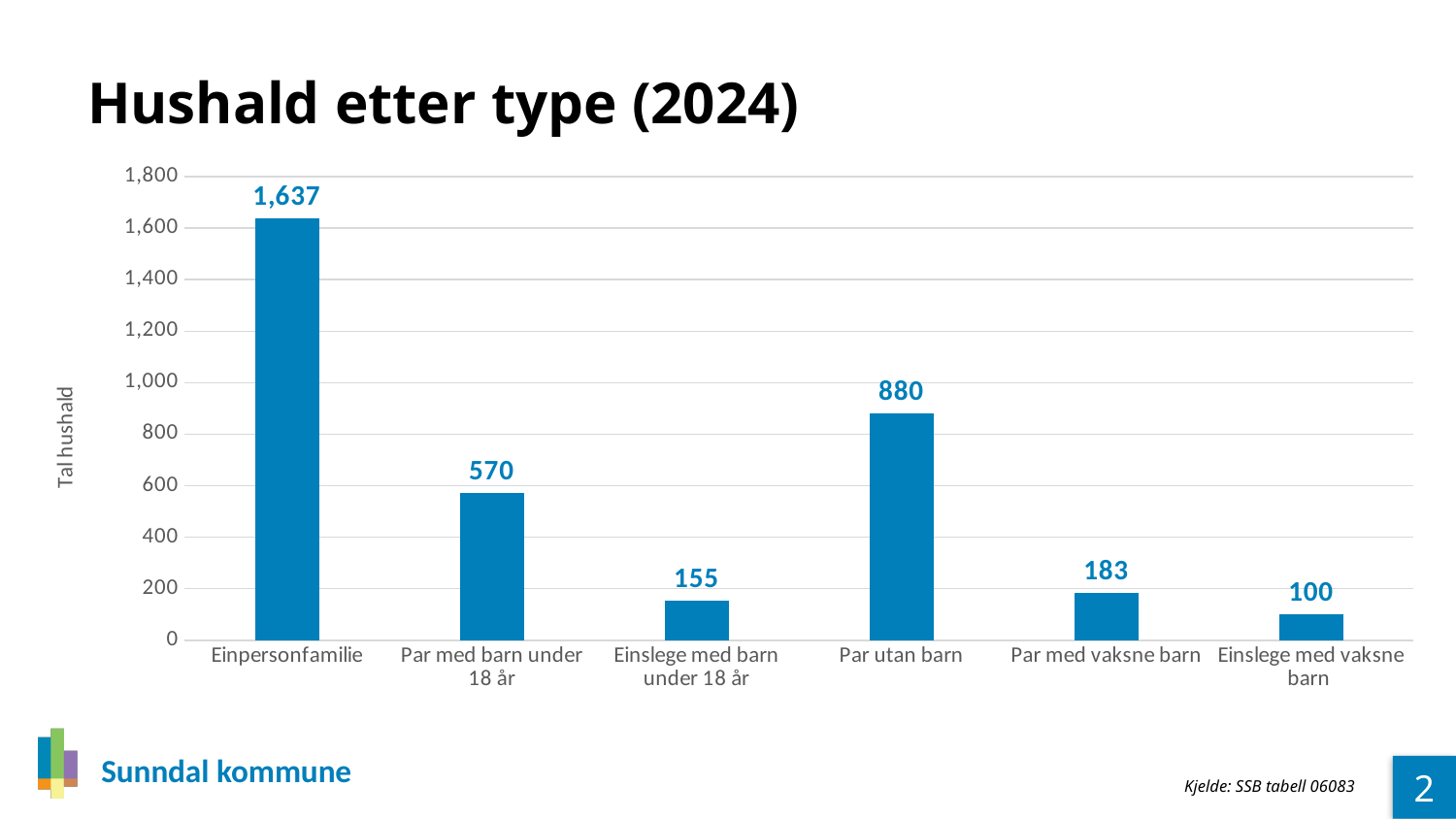
What is the value for Par utan barn? 880 Which household type has the highest number of households? Einpersonfamilie What is the difference between Einpersonfamilie and Par utan barn? 757 What kind of chart is shown on the slide? Bar chart What is the difference between Par med barn under 18 år and Par med vaksne barn? 387 Which is larger, Par med vaksne barn or Einslege med barn under 18 år? Par med vaksne barn What is the title of the chart? Hushald etter type (2024) What is the value for Einslege med vaksne barn? 100 How many household types are shown in the chart? 6 Which household type has the lowest number of households? Einslege med vaksne barn What is the value for Einpersonfamilie? 1,637 What is the value for Einslege med barn under 18 år? 155